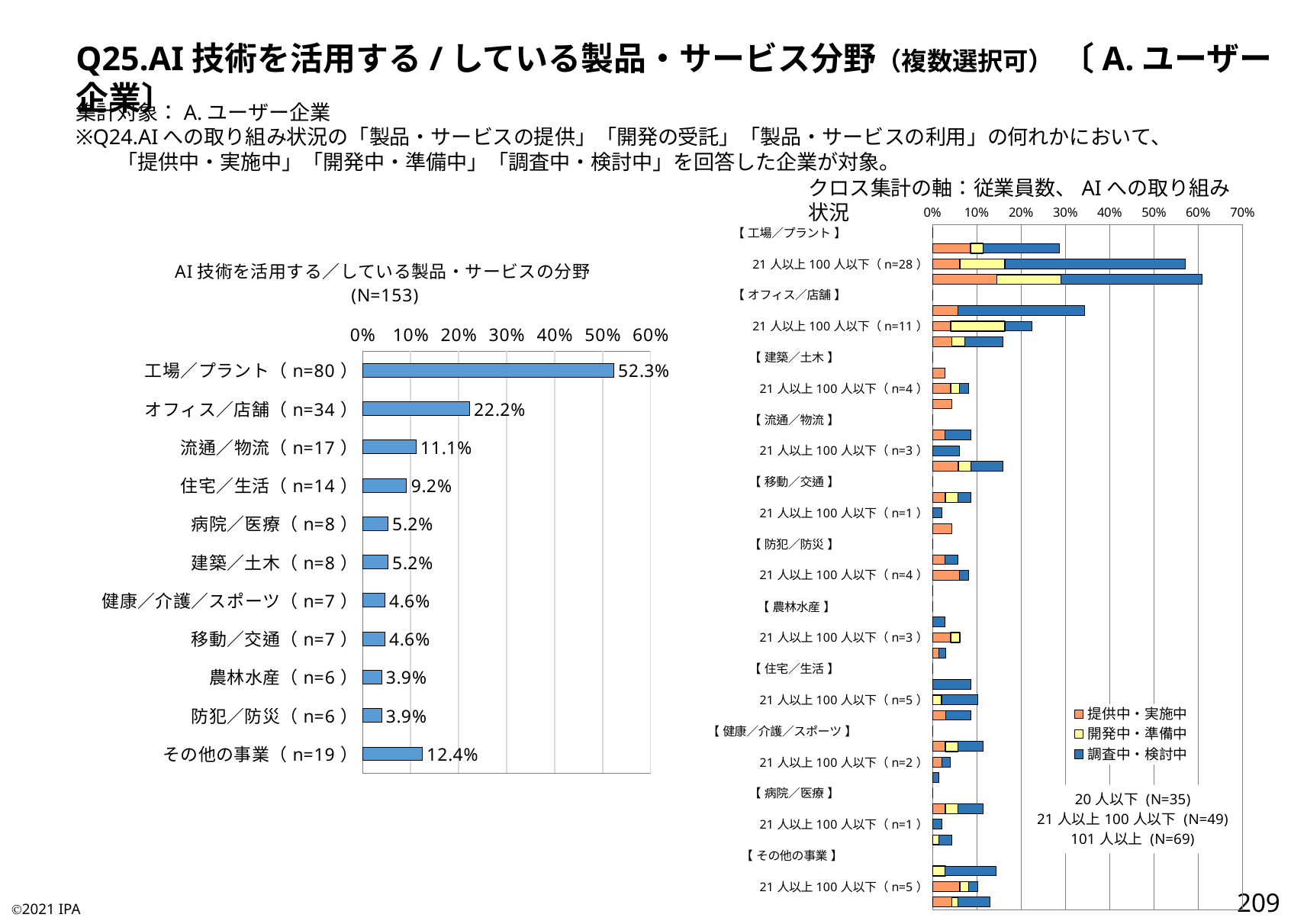
In the left chart, how many categories are plotted? 11 In the left chart (AI技術を活用する／している製品・サービスの分野), what is the value for 工場／プラント? 52.3% In the left chart, what is the value for 農林水産? 3.9% In the left chart, what is the value for オフィス／店舗? 22.2% How many series does the legend of the right chart (クロス集計) list? 3 In the left chart, what is the difference between 工場／プラント and オフィス／店舗? 30.1% In the left chart, which is larger, 流通／物流 or 住宅／生活? 流通／物流 In the left chart, what is the value for その他の事業? 12.4% In the left chart, which category has the highest value? 工場／プラント What is the N shown in the title of the left chart? N=153 In the right chart, is the total value for 工場／プラント, 21人以上100人以下 greater or less than 50%? greater What kind of chart is the left chart? Bar chart